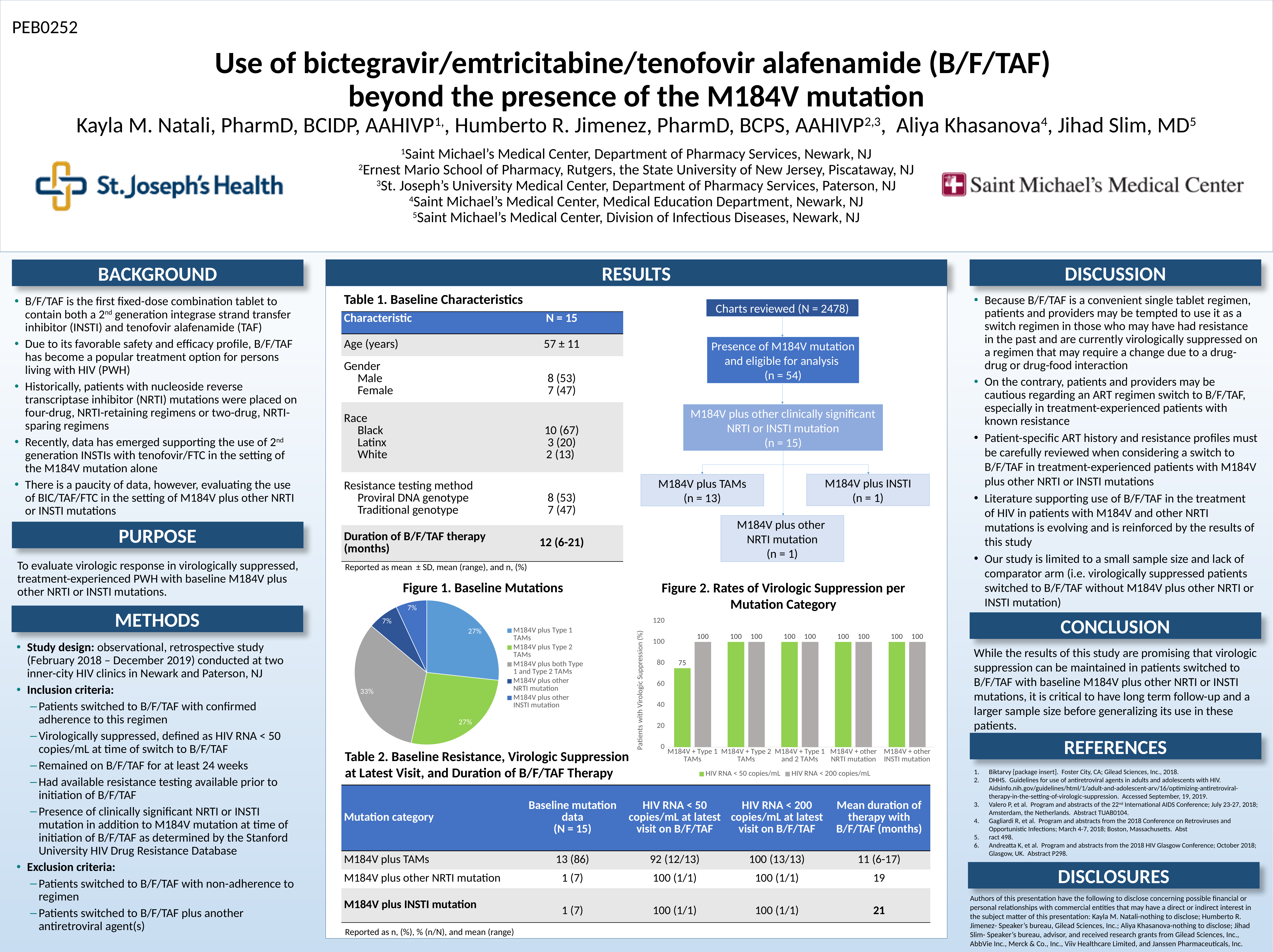
In Figure 2 (Rates of Virologic Suppression per Mutation Category), what is the HIV RNA < 200 copies/mL value for M184V + other INSTI mutation? 100 In Figure 1 (Baseline Mutations), what kind of chart is shown? Pie chart In Figure 2 (Rates of Virologic Suppression per Mutation Category), what is the difference between the HIV RNA < 200 copies/mL and HIV RNA < 50 copies/mL values for M184V + Type 1 TAMs? 25 In Figure 1 (Baseline Mutations), what share of the pie is M184V plus both Type 1 and Type 2 TAMs? 33% In Figure 2 (Rates of Virologic Suppression per Mutation Category), what is the HIV RNA < 50 copies/mL value for M184V + Type 1 TAMs? 75 In Figure 1 (Baseline Mutations), how many categories does the legend list? 5 In Figure 1 (Baseline Mutations), what is the difference between the share for M184V plus Type 1 TAMs and the share for M184V plus other NRTI mutation? 20% In Figure 1 (Baseline Mutations), which category has the largest slice? M184V plus both Type 1 and Type 2 TAMs In Figure 2 (Rates of Virologic Suppression per Mutation Category), what kind of chart is shown? Bar chart In Figure 1 (Baseline Mutations), what share of the pie is M184V plus other INSTI mutation? 7% In Figure 2 (Rates of Virologic Suppression per Mutation Category), how many series does the legend list? 2 In Figure 2 (Rates of Virologic Suppression per Mutation Category), which mutation category has the lowest HIV RNA < 50 copies/mL value? M184V + Type 1 TAMs